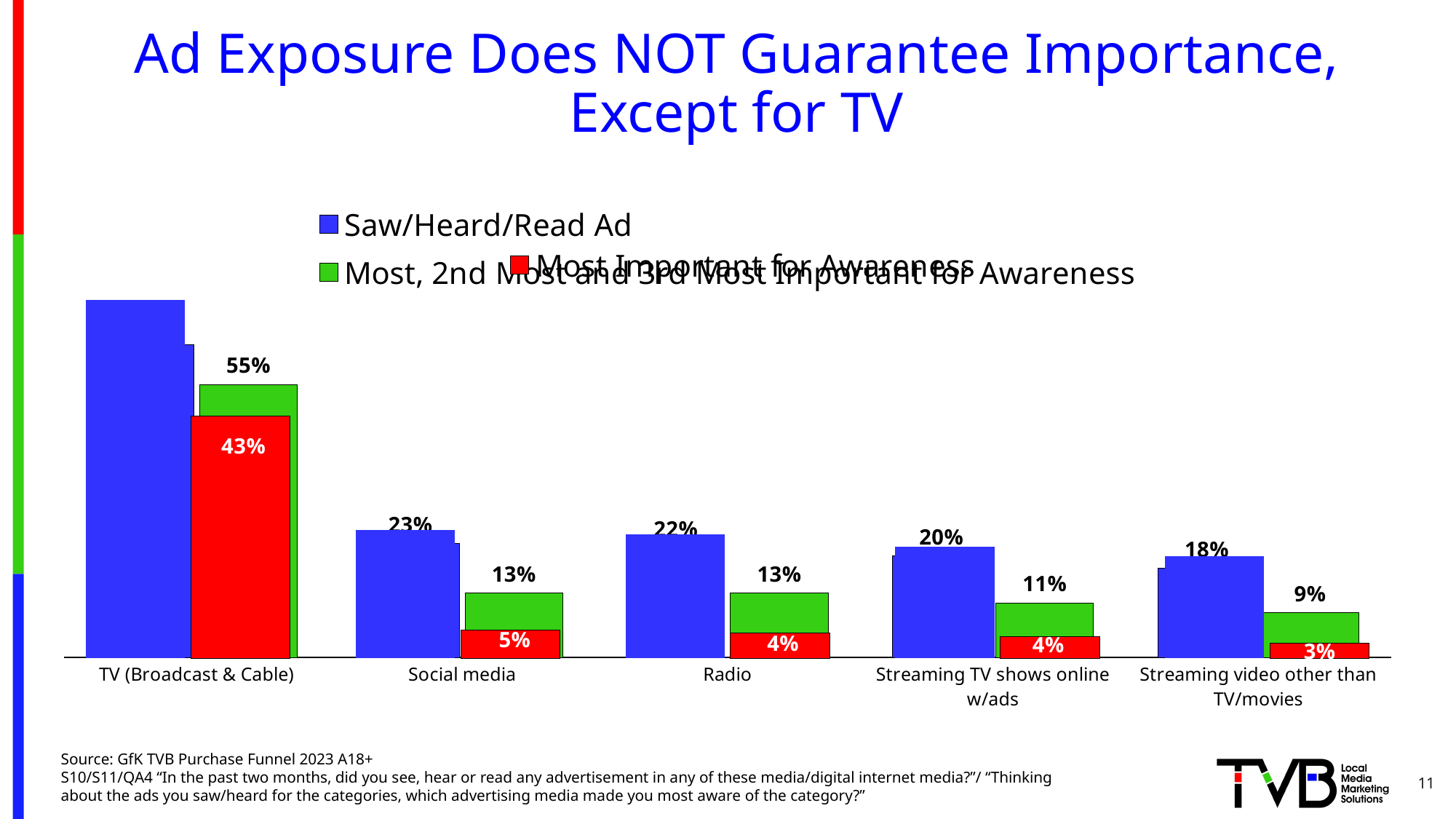
How many media categories are shown on the x axis? 5 Which colour represents the 'Saw/Heard/Read Ad' series? blue Which category has the highest 'Most Important for Awareness' value? TV (Broadcast & Cable) What is the 'Most Important for Awareness' value for TV (Broadcast & Cable)? 43% Which category has the lowest 'Most, 2nd Most and 3rd Most Important for Awareness' value? Streaming video other than TV/movies What is the 'Most Important for Awareness' value for Streaming video other than TV/movies? 3% Which is larger: the 'Saw/Heard/Read Ad' value for Radio or for Streaming video other than TV/movies? Radio What is the difference between the 'Most, 2nd Most and 3rd Most Important for Awareness' value and the 'Most Important for Awareness' value for TV (Broadcast & Cable)? 12% How many series does the legend list? 3 What kind of chart is shown on the slide? bar chart What is the 'Most, 2nd Most and 3rd Most Important for Awareness' value for TV (Broadcast & Cable)? 55% What is the 'Saw/Heard/Read Ad' value for Social media? 23%